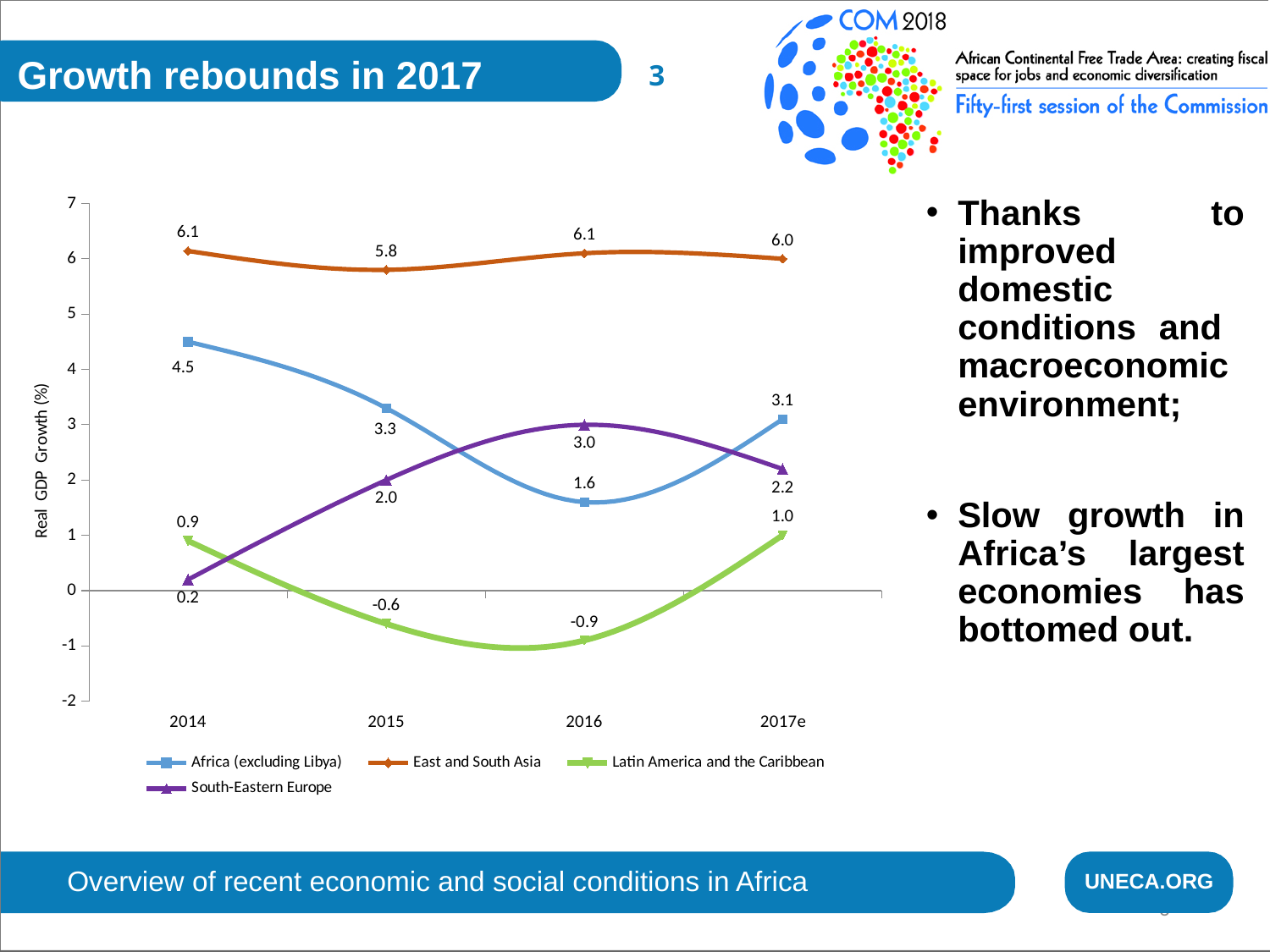
How many series does the legend list? 4 In 2016, which is larger: the value for South-Eastern Europe or the value for Africa (excluding Libya)? South-Eastern Europe Which series has the lowest value in 2015? Latin America and the Caribbean How many years are shown on the x axis? 4 What is the value for South-Eastern Europe in 2017e? 2.2 What is the difference between the Africa (excluding Libya) values in 2014 and 2016? 2.9 What is the value for Latin America and the Caribbean in 2016? -0.9 What kind of chart is shown on the slide? Line chart What is the value for Africa (excluding Libya) in 2014? 4.5 What is the value for East and South Asia in 2015? 5.8 Which series has the highest value in 2017e? East and South Asia What is the label of the y axis? Real GDP Growth (%)